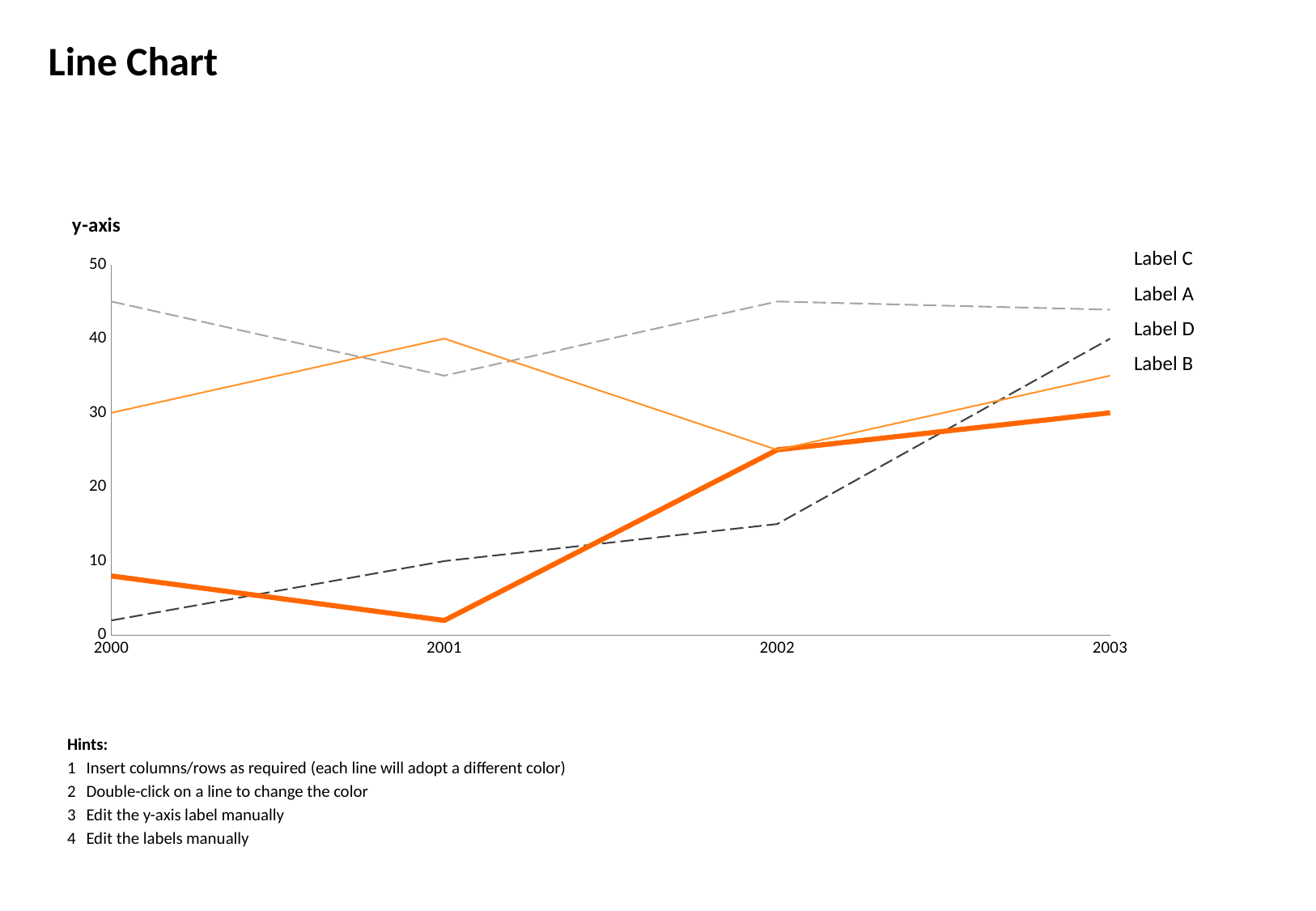
How many years are shown on the x axis of the chart? 4 What kind of chart is shown on the slide? line chart Is the value of the thick orange line in 2001 greater or less than 10? less In 2002, which is larger: the thick orange line or the dark gray dashed line? the thick orange line Is the value of the light gray dashed line in 2002 greater or less than 40? greater What is the value of the thick orange line in 2003? 30 Which line has the highest value in 2000? the light gray dashed line How many series labels are listed to the right of the chart? 4 What is the value of the thin orange line in 2000? 30 What is the title of the slide? Line Chart What is the value of the thin orange line in 2001? 40 What is the value of the dark gray dashed line in 2003? 40